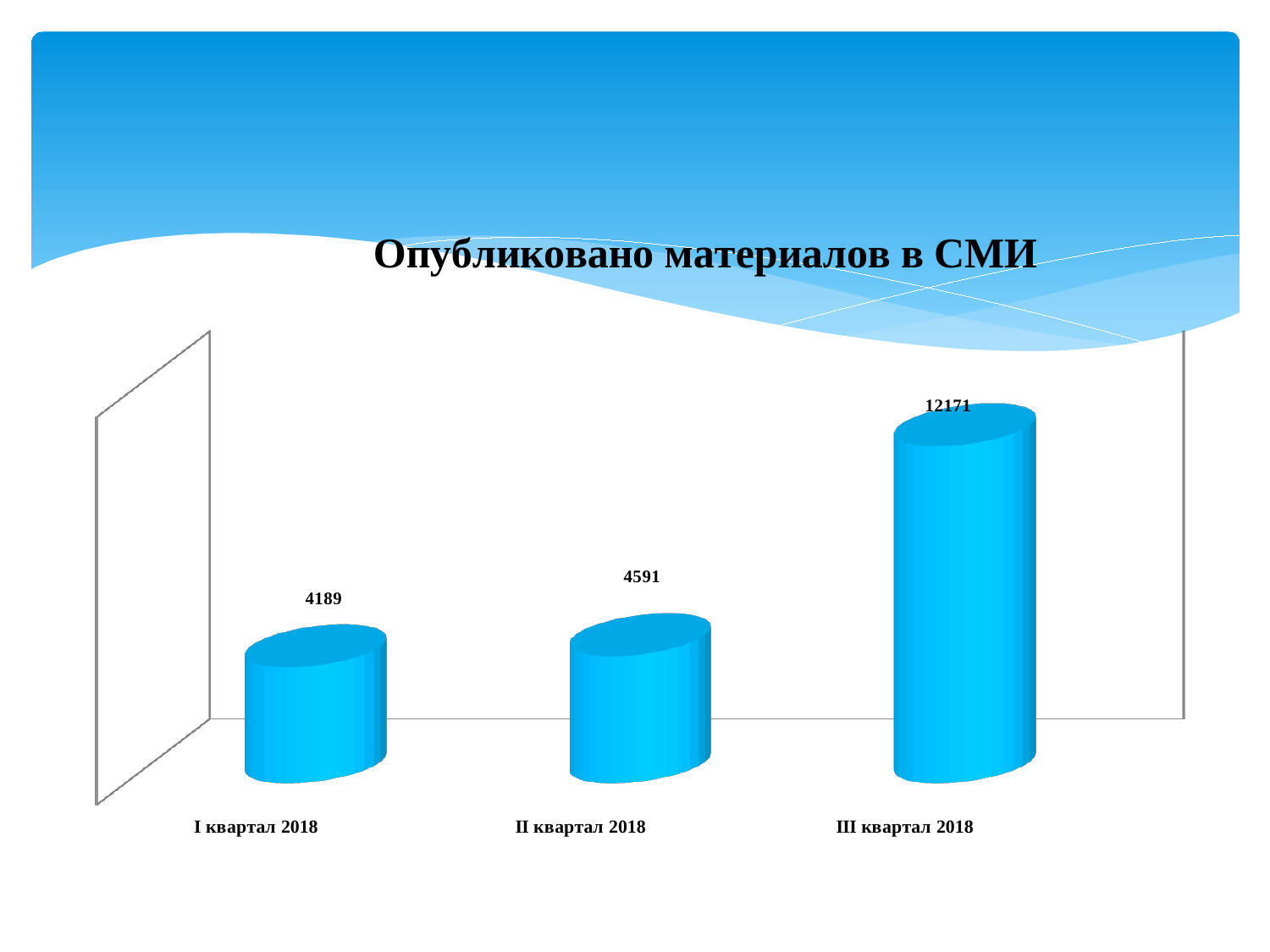
Which quarter has the highest value? III квартал 2018 Which is larger, the value for II квартал 2018 or the value for I квартал 2018? II квартал 2018 What is the difference between the values for II квартал 2018 and I квартал 2018? 402 What is the value for III квартал 2018? 12171 What is the value for II квартал 2018? 4591 What kind of chart is this? bar chart How many categories are shown in the chart? 3 Which quarter has the lowest value? I квартал 2018 Do the values rise or fall from I квартал 2018 to III квартал 2018? rise What is the value for I квартал 2018? 4189 What is the title of the chart? Опубликовано материалов в СМИ What is the difference between the values for III квартал 2018 and II квартал 2018? 7580